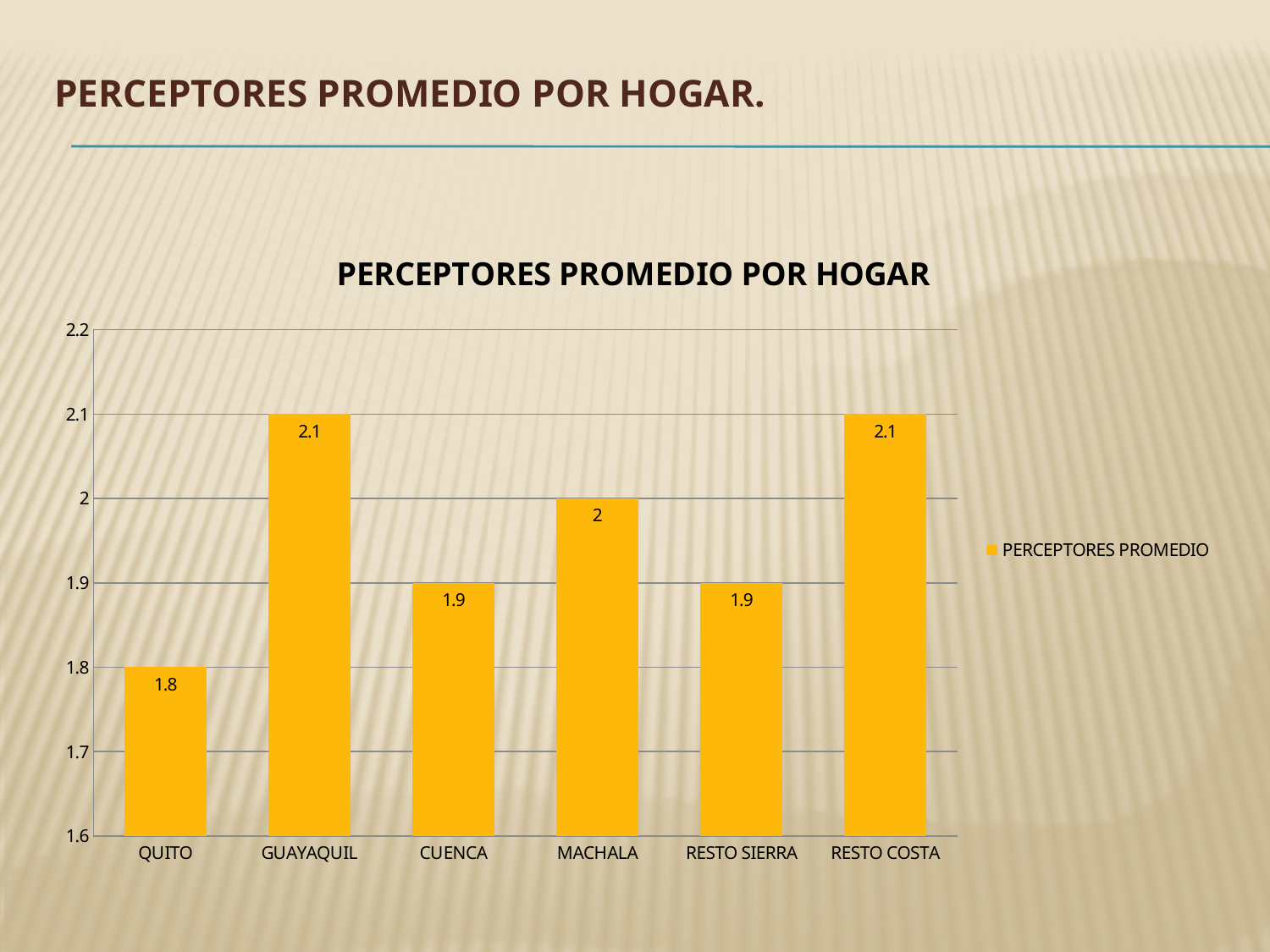
How many categories are shown on the x axis? 6 What is the value for QUITO? 1.8 Which is larger, the value for MACHALA or the value for CUENCA? MACHALA What is the difference between the values for MACHALA and CUENCA? 0.1 How many series does the legend list? 1 What kind of chart is shown? bar chart What is the value for MACHALA? 2 What is the difference between the values for GUAYAQUIL and QUITO? 0.3 Is the value for RESTO COSTA greater or less than 2? greater What is the title of the chart? PERCEPTORES PROMEDIO POR HOGAR Which category has the lowest value? QUITO What is the value for RESTO SIERRA? 1.9